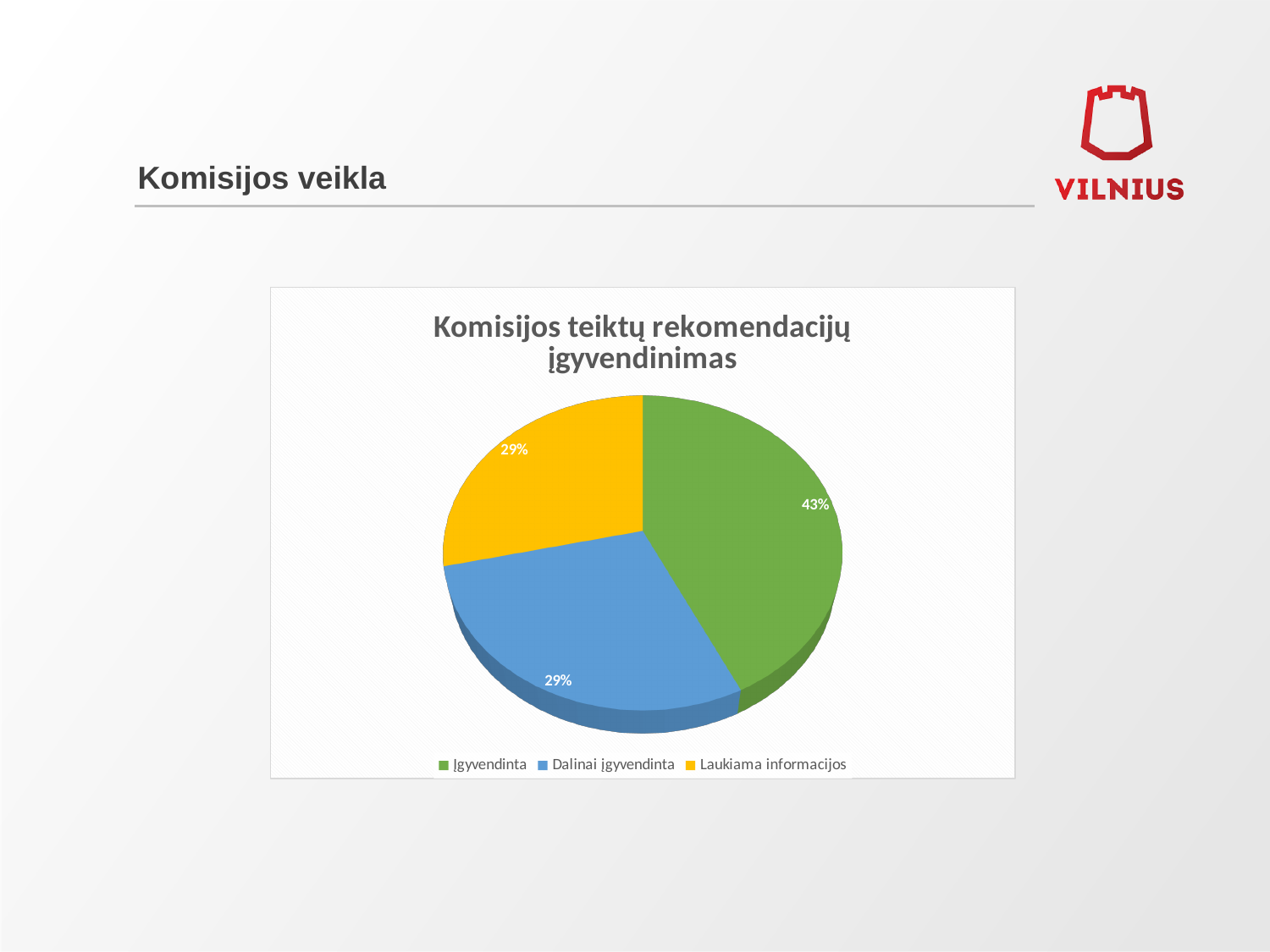
What share of the pie does Dalinai įgyvendinta take? 29% What kind of chart is shown on the slide? pie chart How many entries does the legend list? 3 Which is larger, the slice for Įgyvendinta or the slice for Laukiama informacijos? Įgyvendinta How many slices does the pie chart have? 3 What is the difference in percentage points between Įgyvendinta and Dalinai įgyvendinta? 14 What colour is the slice for Laukiama informacijos? yellow What share of the pie does Laukiama informacijos take? 29% What share of the pie does Įgyvendinta take? 43% Which category has the largest slice of the pie? Įgyvendinta What is the title of the chart? Komisijos teiktų rekomendacijų įgyvendinimas